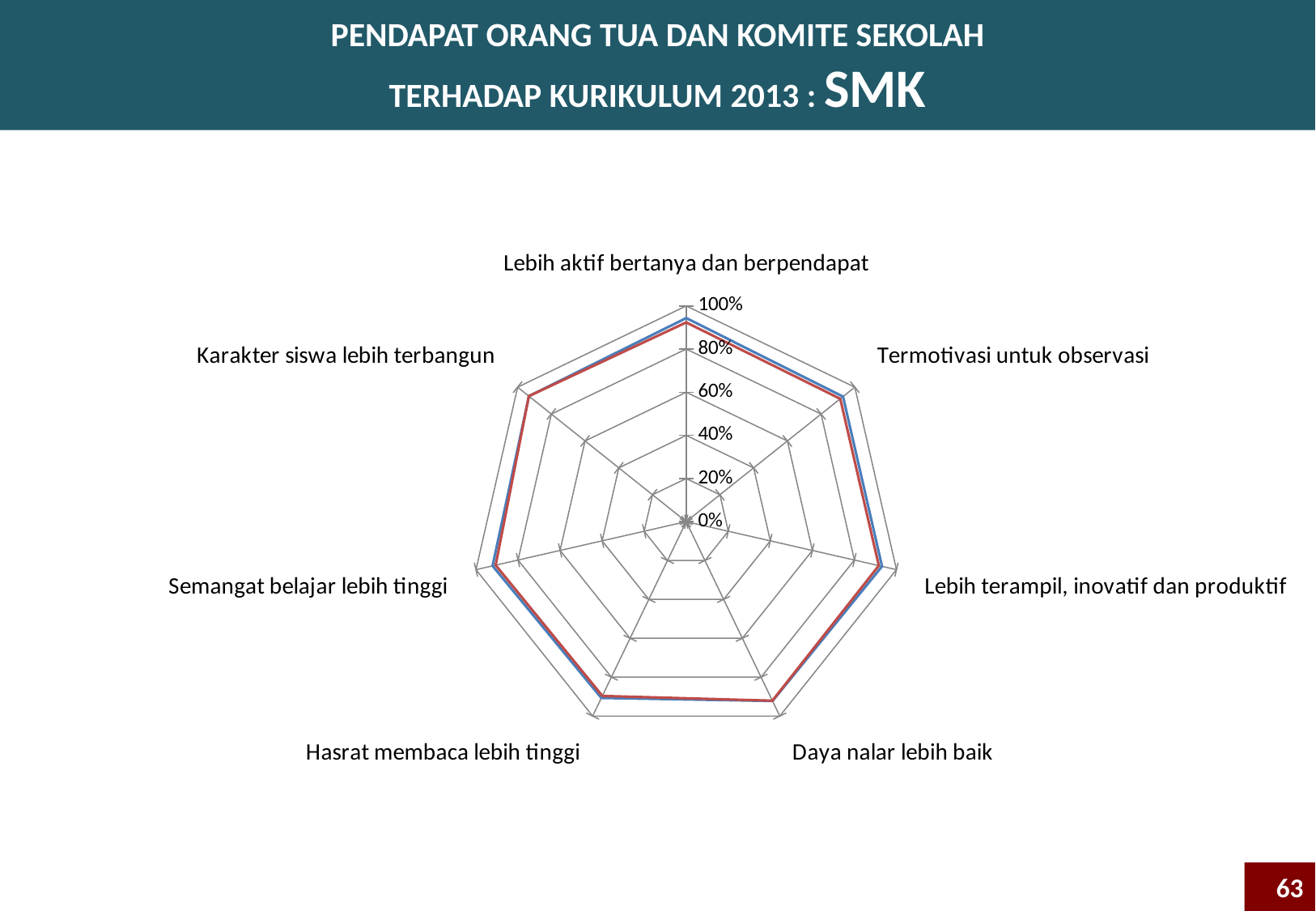
Is the value for Daya nalar lebih baik greater or less than 100%? less What is the maximum value shown on the radar chart's axis scale? 100% Is the value for Lebih aktif bertanya dan berpendapat greater or less than 80%? greater Which category label appears at the top of the radar chart? Lebih aktif bertanya dan berpendapat Is the value for Karakter siswa lebih terbangun greater or less than 80%? greater What kind of chart is shown on the slide? Radar chart How many categories (axes) does the radar chart have? 7